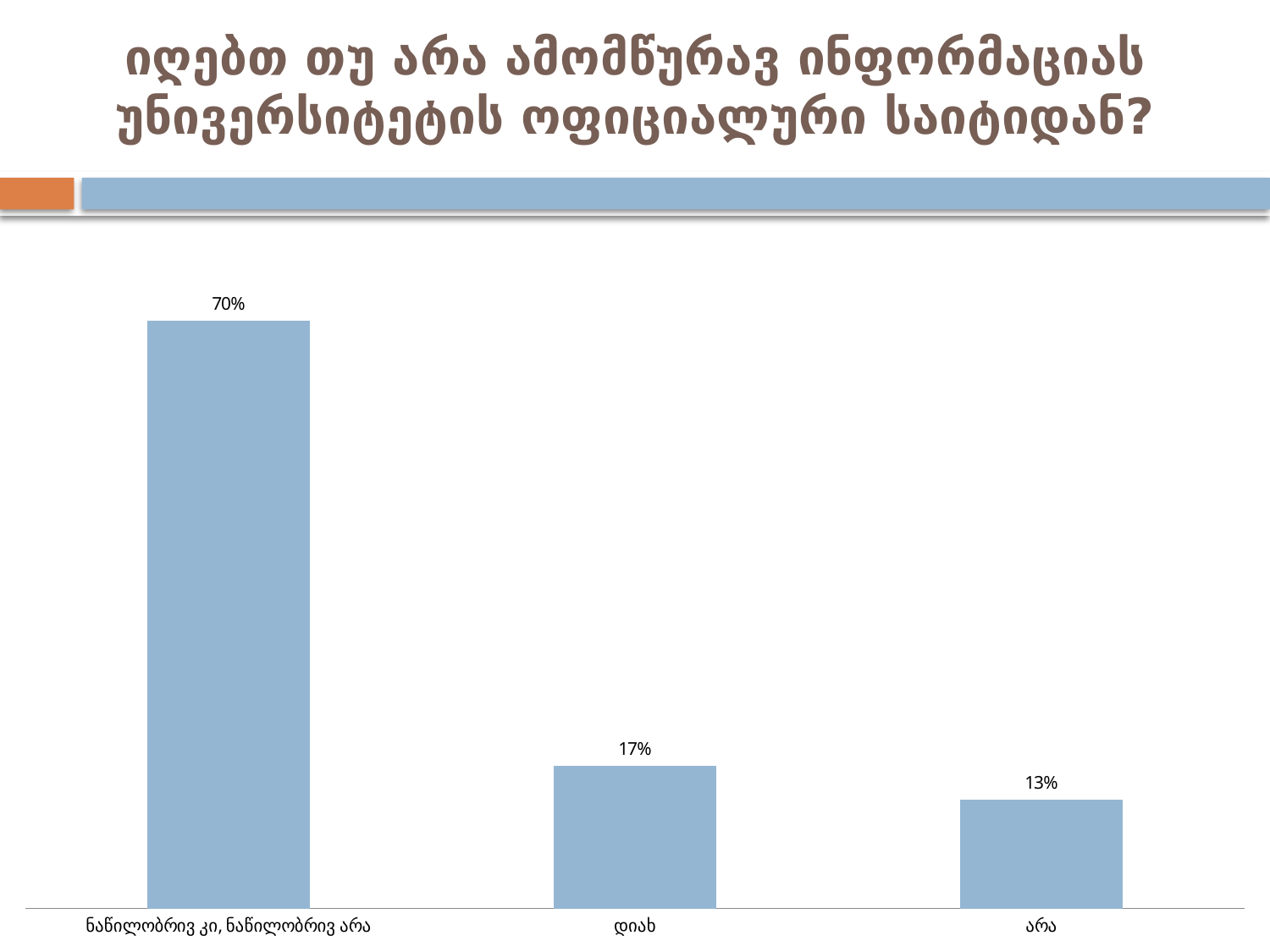
What kind of chart is shown on the slide? Bar chart Do the values rise or fall from left to right across the categories? Fall What is the difference between the values for "ნაწილობრივ კი, ნაწილობრივ არა" and "დიახ"? 53% What value is shown for the category "დიახ"? 17% How many categories are shown in the chart? 3 Which category has the lowest value? არა What value is shown for the category "ნაწილობრივ კი, ნაწილობრივ არა"? 70% Which is larger, the value for "დიახ" or the value for "არა"? დიახ What is the difference between the values for "დიახ" and "არა"? 4% What value is shown for the category "არა"? 13% What is the title of the slide? იღებთ თუ არა ამომწურავ ინფორმაციას უნივერსიტეტის ოფიციალური საიტიდან? Which category has the highest value? ნაწილობრივ კი, ნაწილობრივ არა